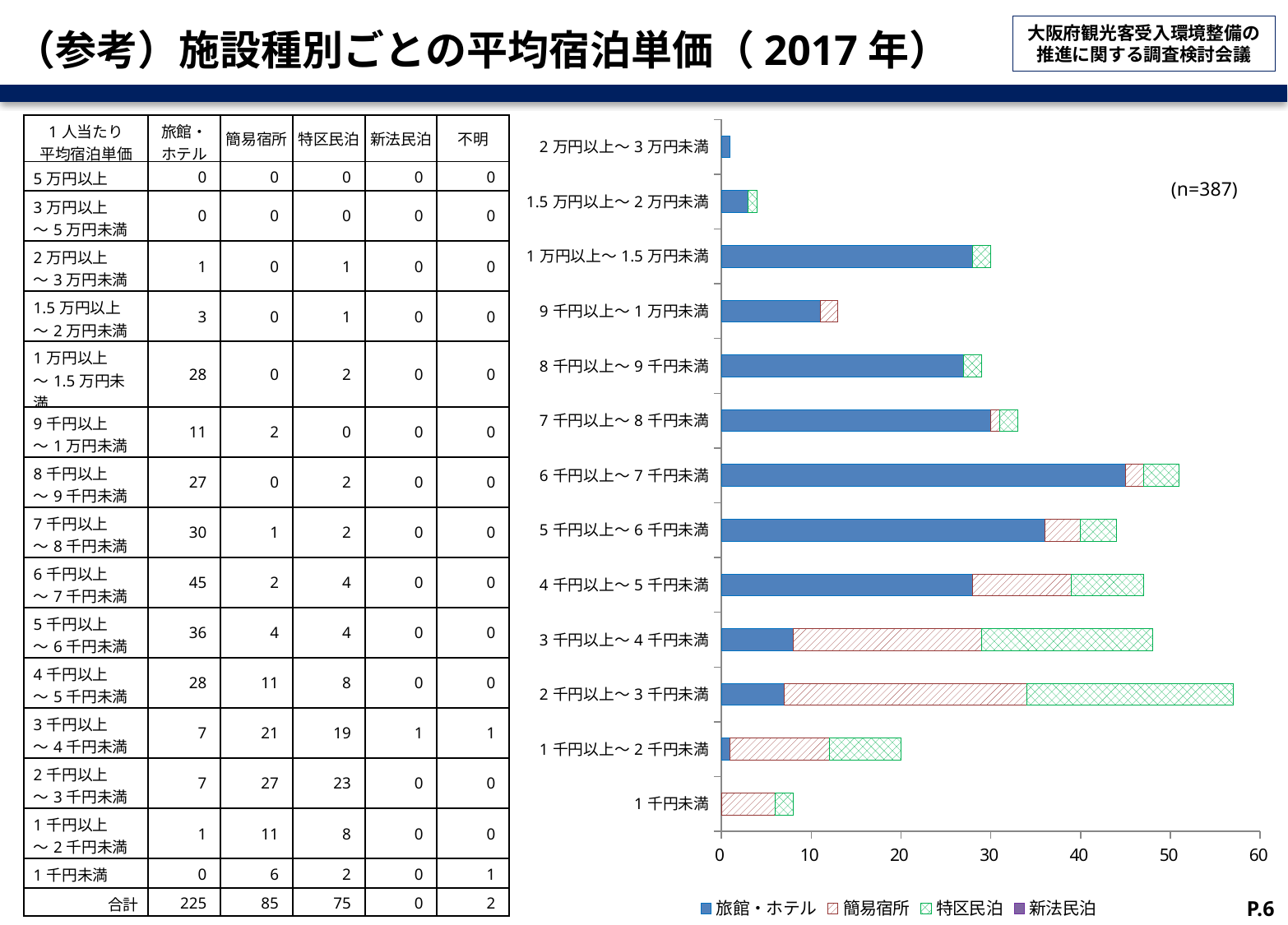
According to the table, what is the 旅館・ホテル value for 6千円以上～7千円未満? 45 How many price-range categories are plotted on the chart? 13 Is the total bar for 1.5万円以上～2万円未満 greater or less than 10? less What kind of chart is shown on the slide? stacked bar chart Which price range has the shortest total bar in the chart? 2万円以上～3万円未満 Which price range has the longest total bar in the chart? 2千円以上～3千円未満 How many series does the chart legend list? 4 Is the total bar for 4千円以上～5千円未満 greater or less than 40? greater Is the total bar for 9千円以上～1万円未満 greater or less than 10? greater According to the table, what is the 簡易宿所 value for 2千円以上～3千円未満? 27 What sample size (n) is shown next to the chart? n=387 Which is larger in the chart: the total bar for 3千円以上～4千円未満 or for 7千円以上～8千円未満? 3千円以上～4千円未満